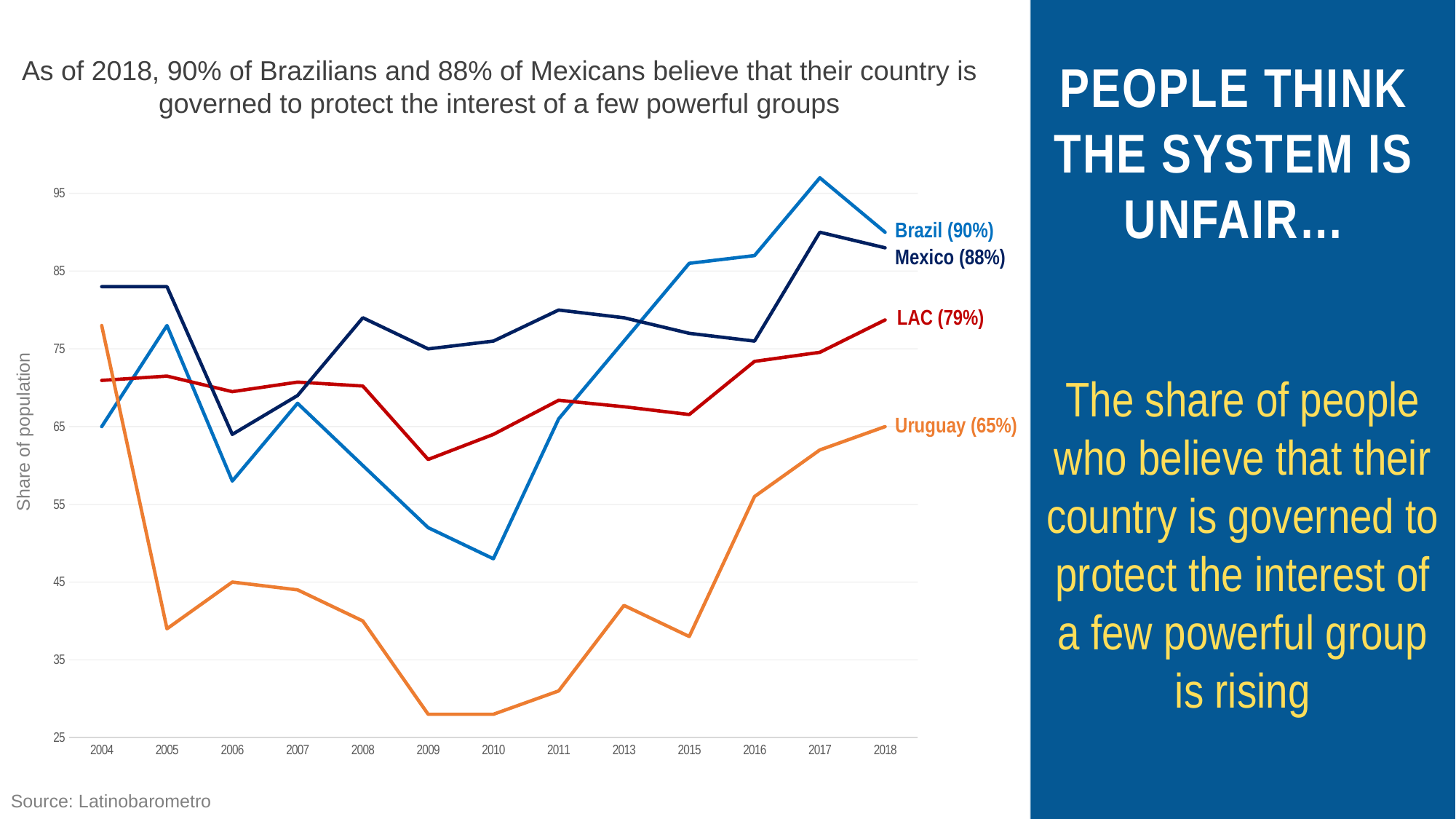
Which series has the lowest value in 2018? Uruguay In 2018, which is larger: the value for Mexico or the value for LAC? Mexico How many series are plotted on the chart? 4 How many years are shown on the x axis? 13 What is the value for LAC in 2018? 79% What kind of chart is shown on the slide? line chart What is the value for Brazil in 2018? 90% Which series has the highest value in 2018? Brazil What is the value for Mexico in 2018? 88% What is the difference between the 2018 values for Brazil and Uruguay? 25 percentage points What is the value for Uruguay in 2018? 65% Is the value for Uruguay in 2009 greater or less than 35? less